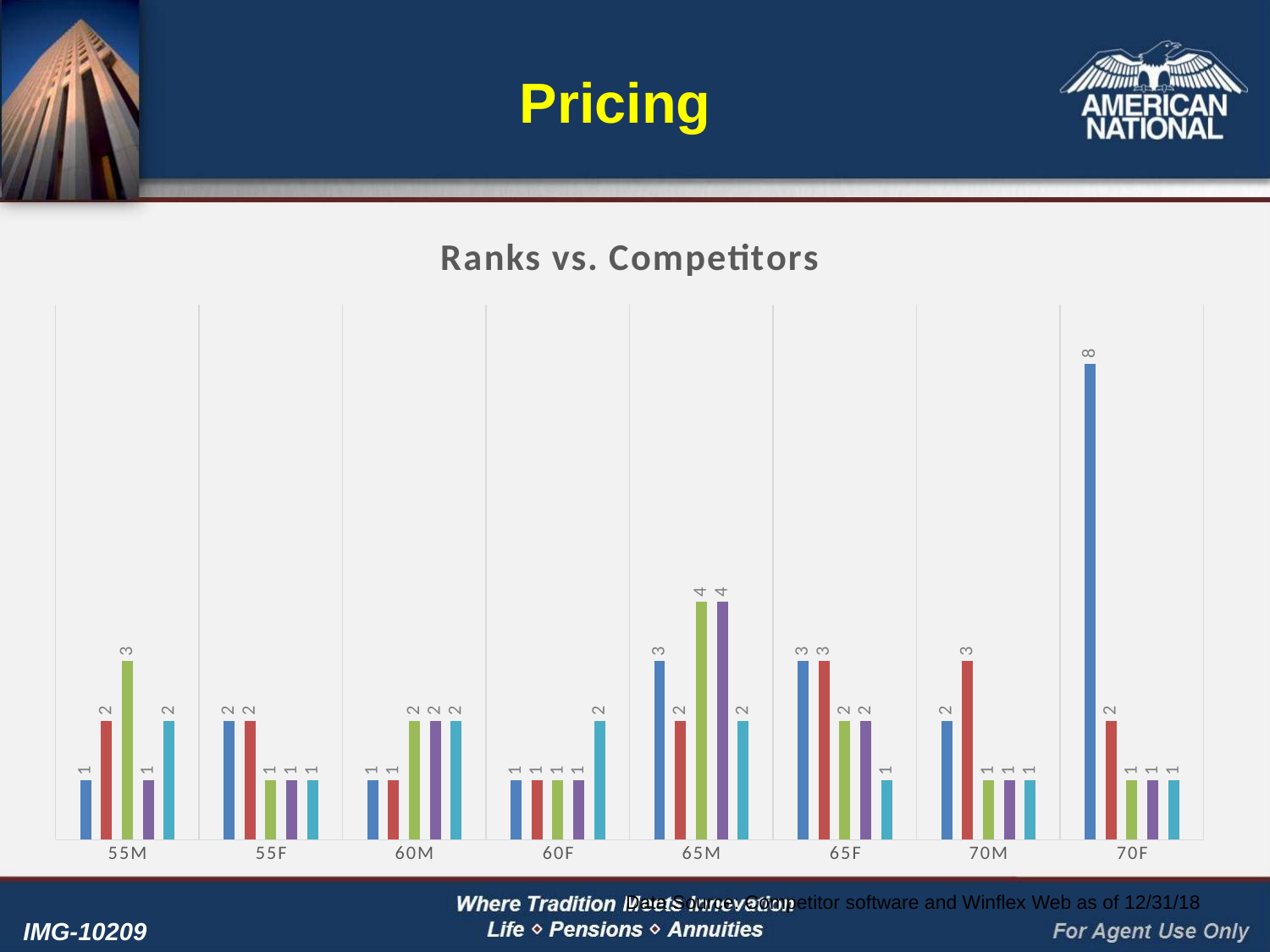
What is the value of the tallest bar in the chart? 8 What is the title of the chart? Ranks vs. Competitors Which category contains the tallest bar in the chart? 70F What is the value of the third (green) bar for 55M? 3 What type of chart is shown on the slide? bar chart How many bars are plotted for each category in the chart? 5 Which is larger: the green bar for 65M or the green bar for 55M? 65M How many categories are shown on the x axis of the chart? 8 What is the value of the fourth (purple) bar for 65M? 4 What is the value of the first (dark blue) bar for 70F? 8 What is the difference between the first (dark blue) bar and the second (red) bar for 70F? 6 What is the value of the fifth (light blue) bar for 60F? 2